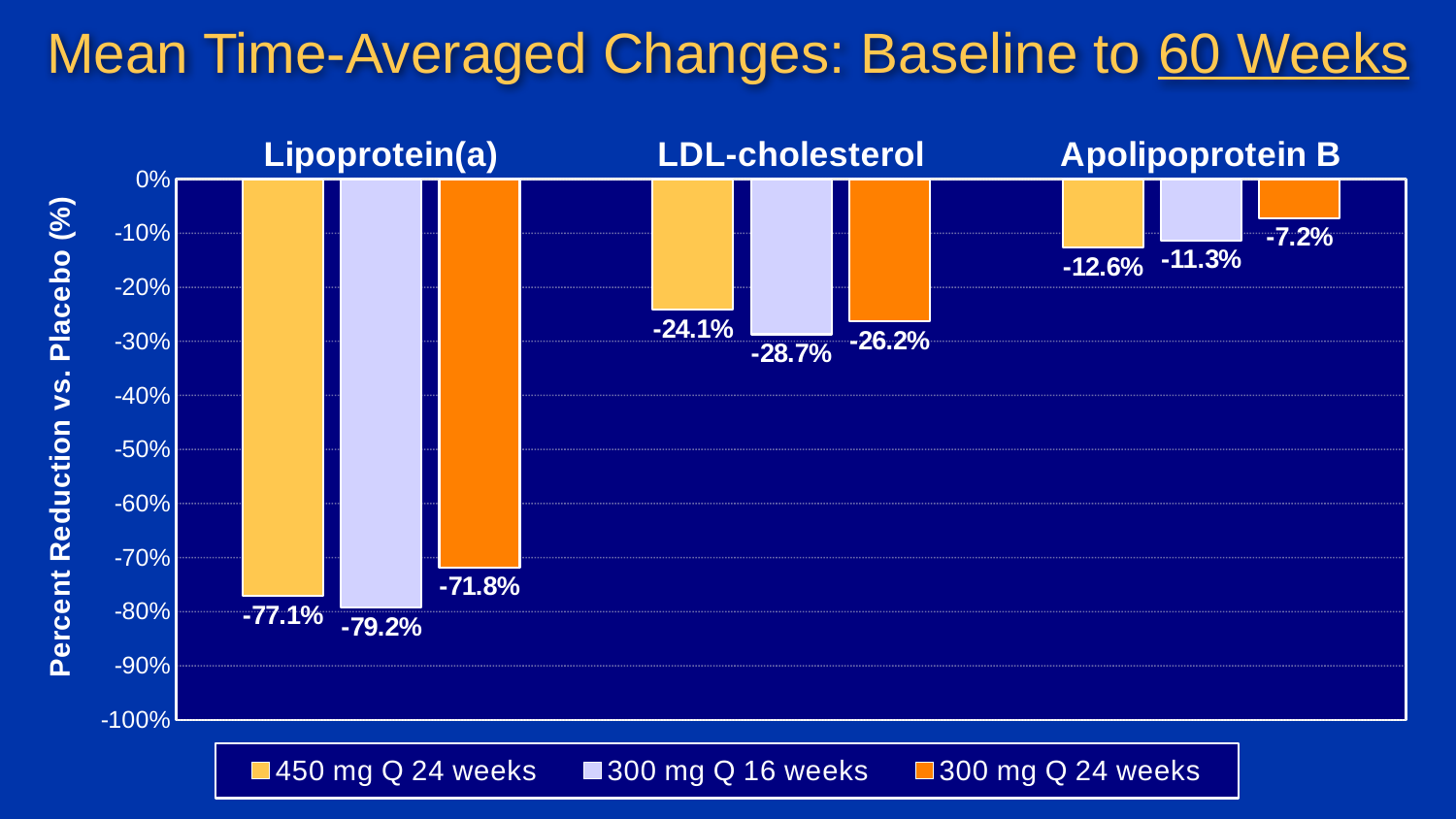
How many categories are shown on the x axis? 3 What kind of chart is shown on the slide? Bar chart Which has a larger reduction for LDL-cholesterol: 300 mg Q 16 weeks or 300 mg Q 24 weeks? 300 mg Q 16 weeks What is the value for 300 mg Q 16 weeks in the Lipoprotein(a) category? -79.2% What is the difference between the 450 mg Q 24 weeks and 300 mg Q 24 weeks values for Lipoprotein(a)? 5.3 percentage points Which series shows the largest reduction for Lipoprotein(a)? 300 mg Q 16 weeks Which series shows the smallest reduction for Apolipoprotein B? 300 mg Q 24 weeks What is the label of the y axis? Percent Reduction vs. Placebo (%) What is the value for 300 mg Q 24 weeks in the Apolipoprotein B category? -7.2% What is the value for 450 mg Q 24 weeks in the LDL-cholesterol category? -24.1% What is the title of the slide? Mean Time-Averaged Changes: Baseline to 60 Weeks How many series does the legend list? 3